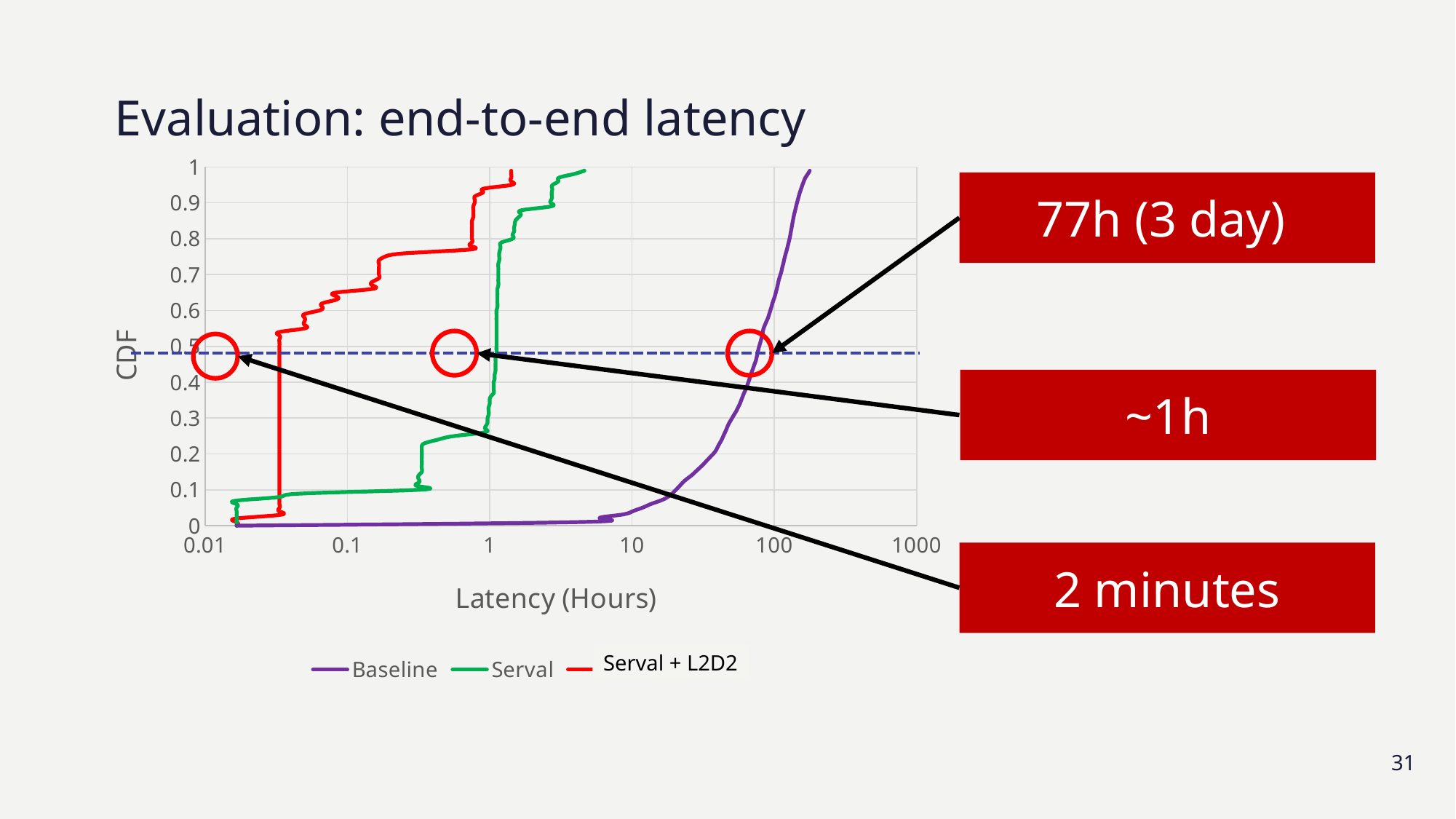
Which series reaches a CDF of 0.5 at a lower latency, Serval or Baseline? Serval What are the three series named in the legend? Baseline, Serval, Serval + L2D2 What is the label of the x axis? Latency (Hours) According to the annotation, what is the median (CDF 0.5) latency for the Baseline series? 77h (3 day) What kind of chart is shown on the slide? Line chart Which series reaches a CDF of 0.5 at the lowest latency? Serval + L2D2 How many series does the legend list? 3 Is the latency at which the Baseline series reaches a CDF of 0.5 greater or less than 10 hours? greater According to the annotation, what is the median (CDF 0.5) latency for the Serval + L2D2 series? 2 minutes According to the annotation, what is the median (CDF 0.5) latency for the Serval series? ~1h Is the latency at which the Serval + L2D2 series reaches a CDF of 0.5 greater or less than 0.1 hours? less Which series reaches a CDF of 0.5 at the highest latency? Baseline